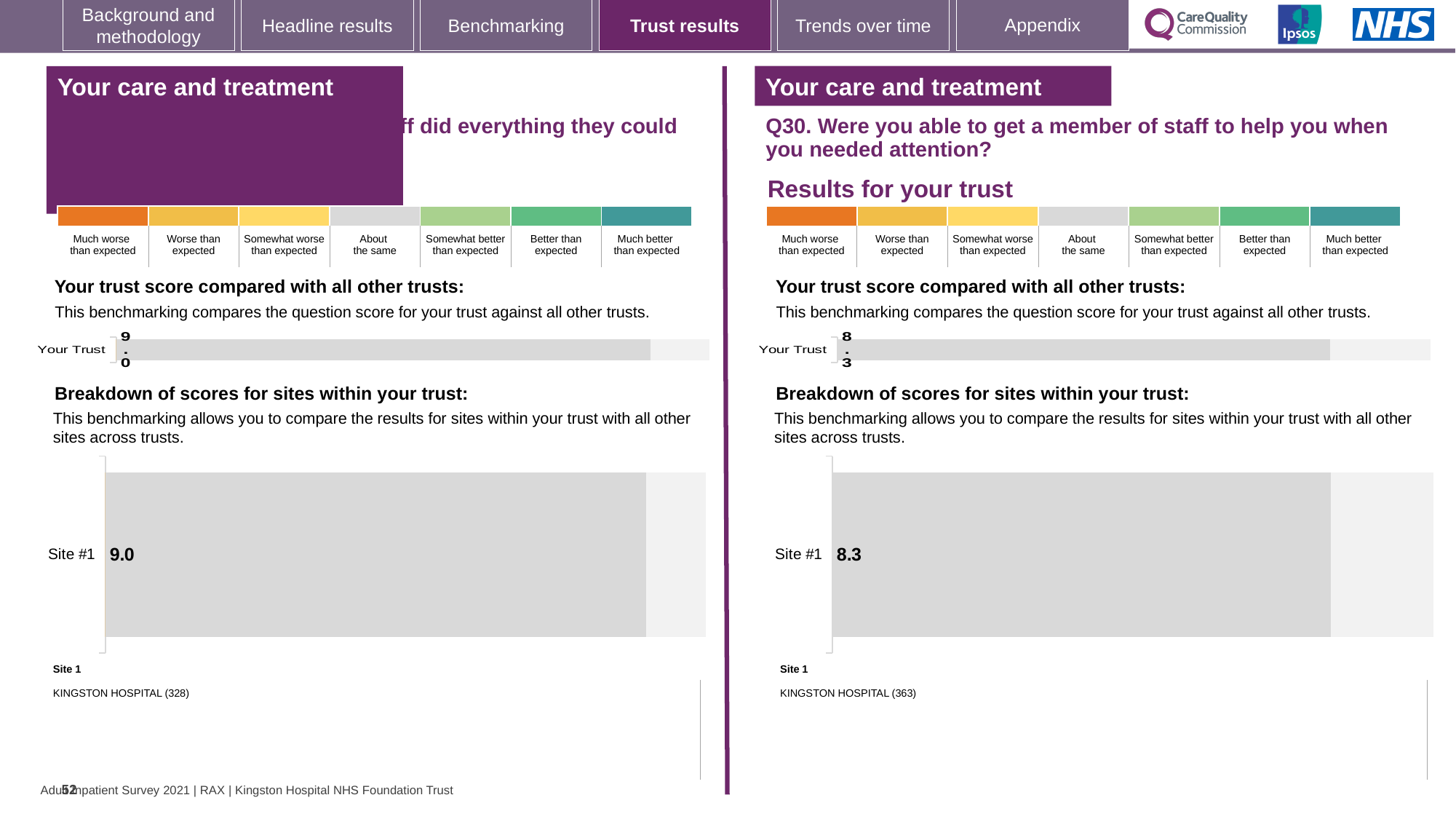
What is the difference between the Site #1 score on the left-hand panel and the Site #1 score on the right-hand panel (Q30)? 0.7 On the left-hand panel, which hospital is listed as Site 1? KINGSTON HOSPITAL (328) What type of chart is used to show the Site #1 score on the left-hand panel? bar chart Which panel shows the higher Your Trust score, the left-hand panel or the right-hand panel (Q30)? the left-hand panel On the right-hand panel (Q30), what score is shown for Site #1 in the breakdown of scores for sites within your trust? 8.3 On the right-hand panel (Q30), what is the score shown for Your Trust? 8.3 On the left-hand panel, what score is shown for Site #1 in the breakdown of scores for sites within your trust? 9.0 How many sites are shown in the breakdown of scores chart on the right-hand panel (Q30)? 1 On the right-hand panel (Q30), which hospital is listed as Site 1? KINGSTON HOSPITAL (363) On the left-hand panel, what is the score shown for Your Trust? 9.0